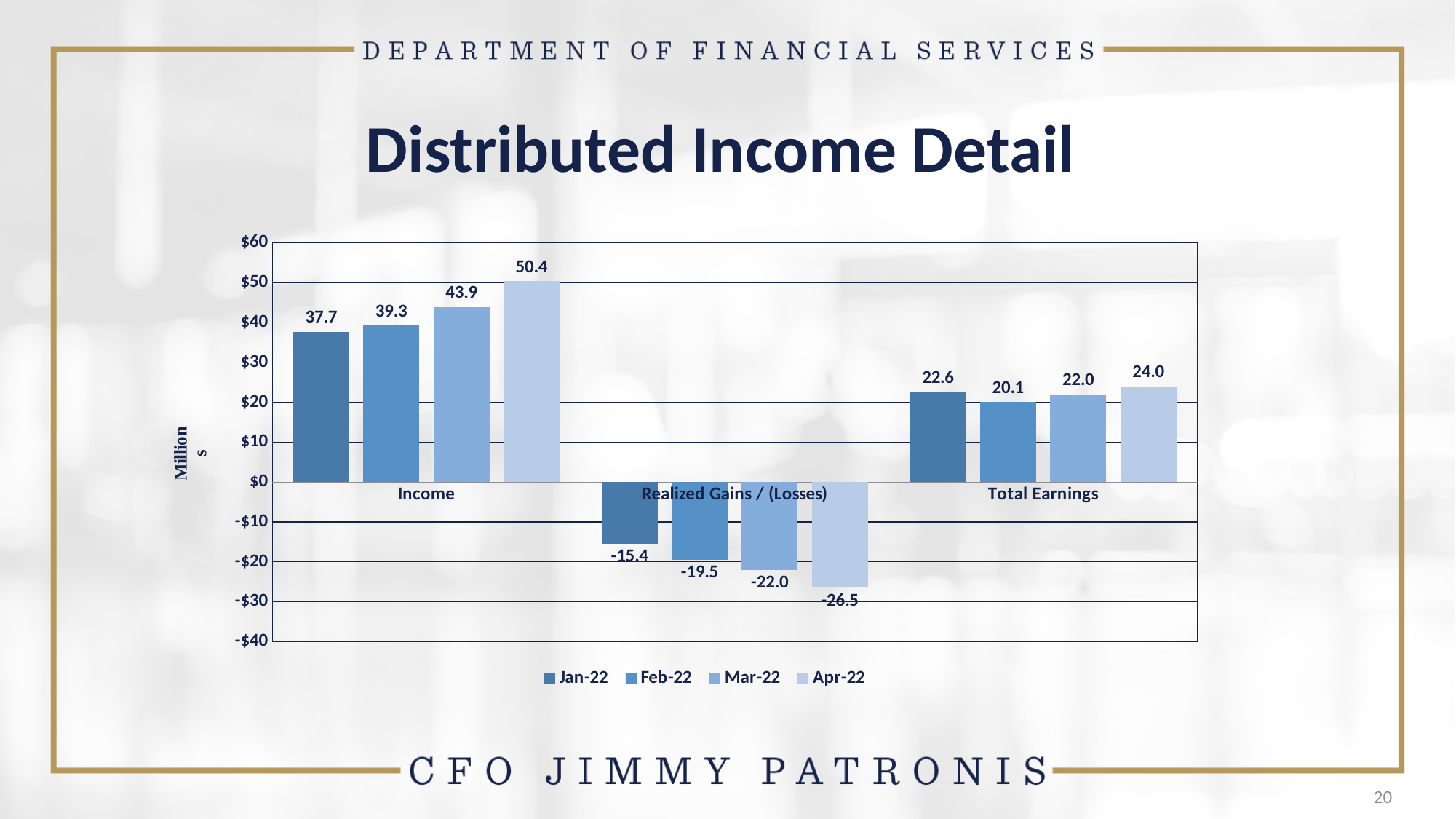
Which is larger, the Total Earnings value for Jan-22 or for Mar-22? Jan-22 What is the Realized Gains / (Losses) value for Feb-22? -19.5 What is the Income value for Apr-22? 50.4 How many series does the legend list? 4 What is the title of the chart? Distributed Income Detail Which month has the lowest Total Earnings value? Feb-22 What kind of chart is shown on the slide? Bar chart What is the Total Earnings value for Mar-22? 22.0 Is the Income value for Mar-22 greater or less than $40? greater How many categories are shown on the x axis? 3 Which month has the highest Income value? Apr-22 What is the difference between the Income values for Apr-22 and Jan-22? 12.7